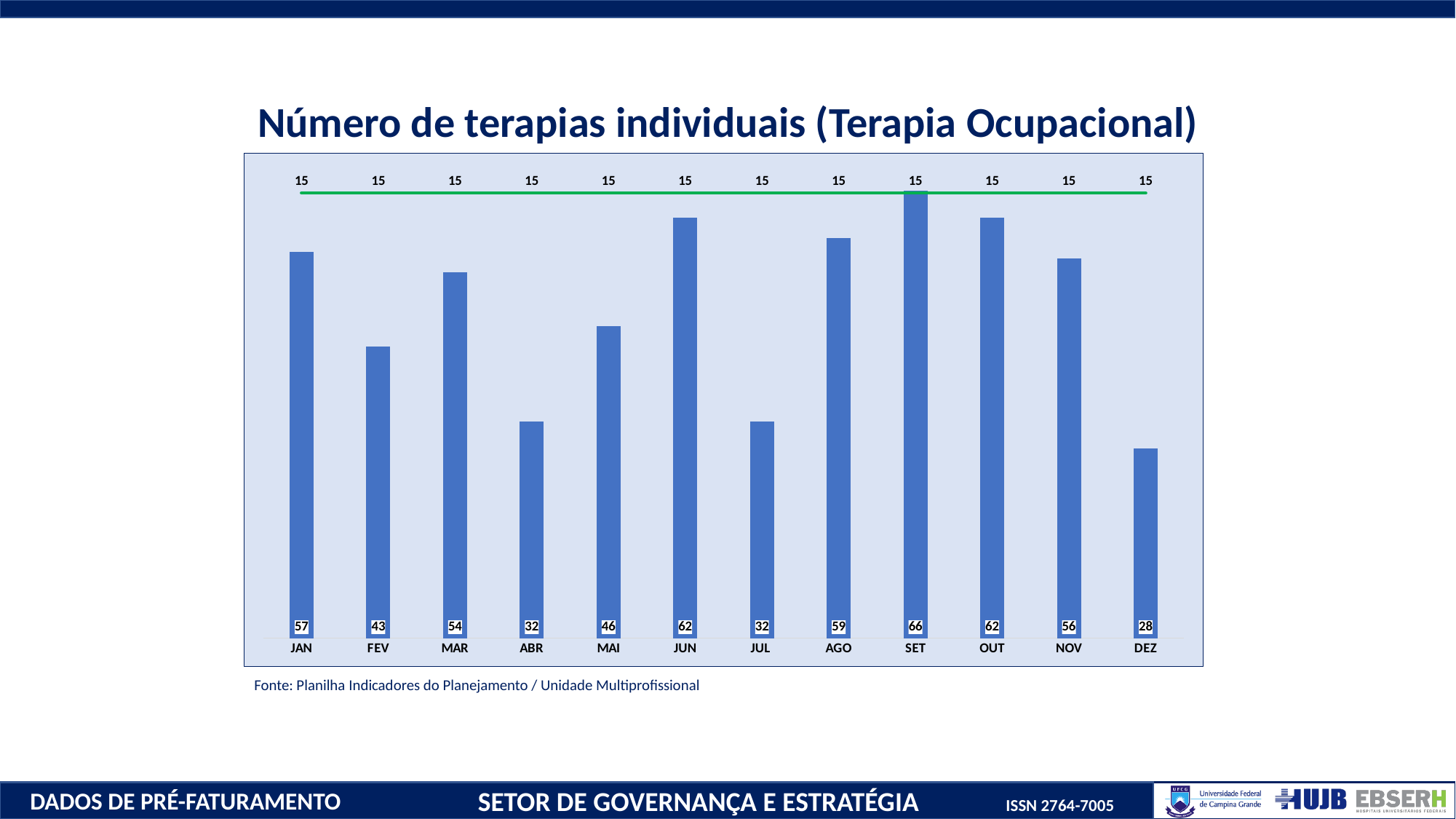
Which month has the highest bar? SET What kind of chart is this? combination bar and line chart What value does the green line show for each month? 15 What is the title of the chart? Número de terapias individuais (Terapia Ocupacional) Which month has the lowest bar? DEZ Which is larger, the value for AGO or the value for NOV? AGO How many months are shown on the x axis? 12 What is the difference between the values for SET and DEZ? 38 What is the value of the bar for SET? 66 What is the value of the bar for MAI? 46 What is the difference between the values for JAN and FEV? 14 What is the value of the bar for DEZ? 28